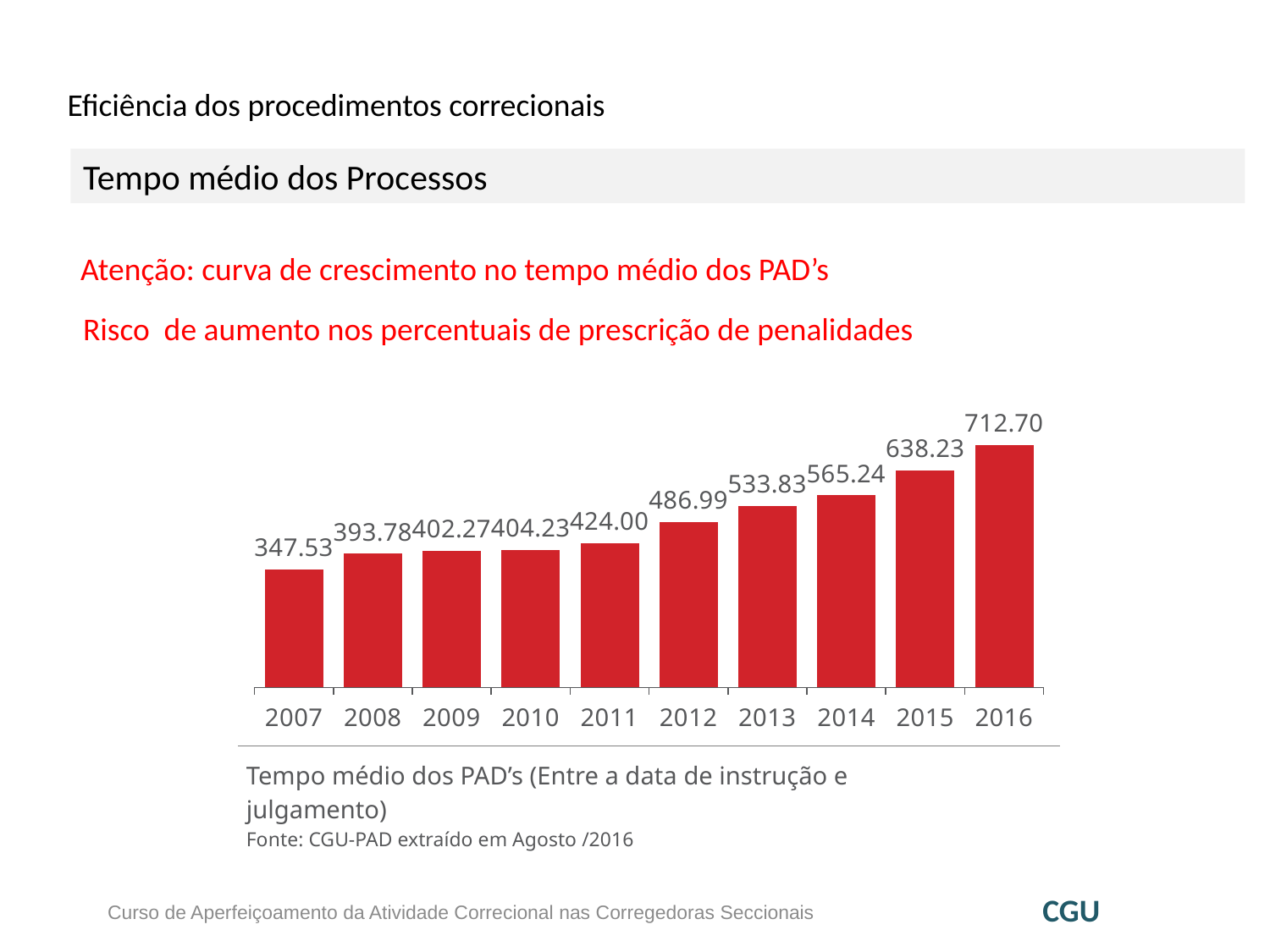
Which year has the lowest value? 2007 What is the value for 2007? 347.53 Which is larger, the value for 2013 or the value for 2011? 2013 What is the value for 2016? 712.70 What is the difference between the values for 2011 and 2007? 76.47 How many years are shown on the x axis? 10 What is the value for 2014? 565.24 What kind of chart is this? bar chart What is the value for 2012? 486.99 What is the difference between the values for 2016 and 2015? 74.47 Do the values rise or fall from 2007 to 2016? rise Which year has the highest value? 2016